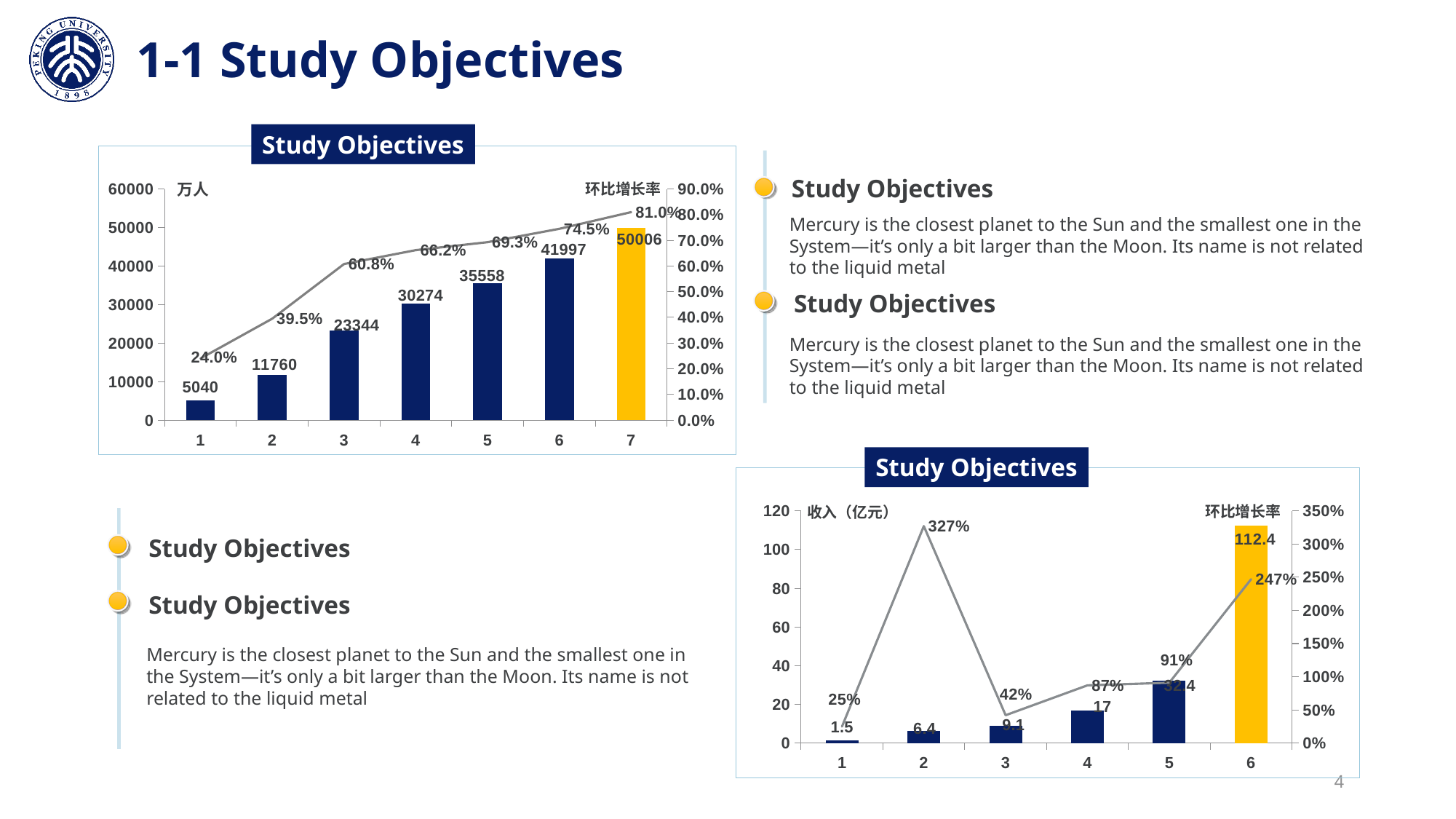
In the top-left chart, how many categories are shown on the x axis? 7 What kind of chart is the bottom-right chart? combined bar and line chart In the top-left chart, which category has the highest bar value? 7 In the bottom-right chart, what is the bar value for category 5? 32.4 In the bottom-right chart, what is the growth rate (环比增长率) shown for category 2? 327% In the top-left chart, what is the growth rate (环比增长率) shown for category 3? 60.8% In the bottom-right chart, which category has the highest growth rate on the line? 2 In the top-left chart, what is the difference between the bar values for category 7 and category 6? 8009 In the bottom-right chart, which category has the lowest bar value? 1 In the top-left chart, what is the bar value for category 4? 30274 In the bottom-right chart, is the growth rate for category 6 larger or smaller than the growth rate for category 5? larger In the top-left chart, do the bar values rise or fall from category 1 to category 7? rise